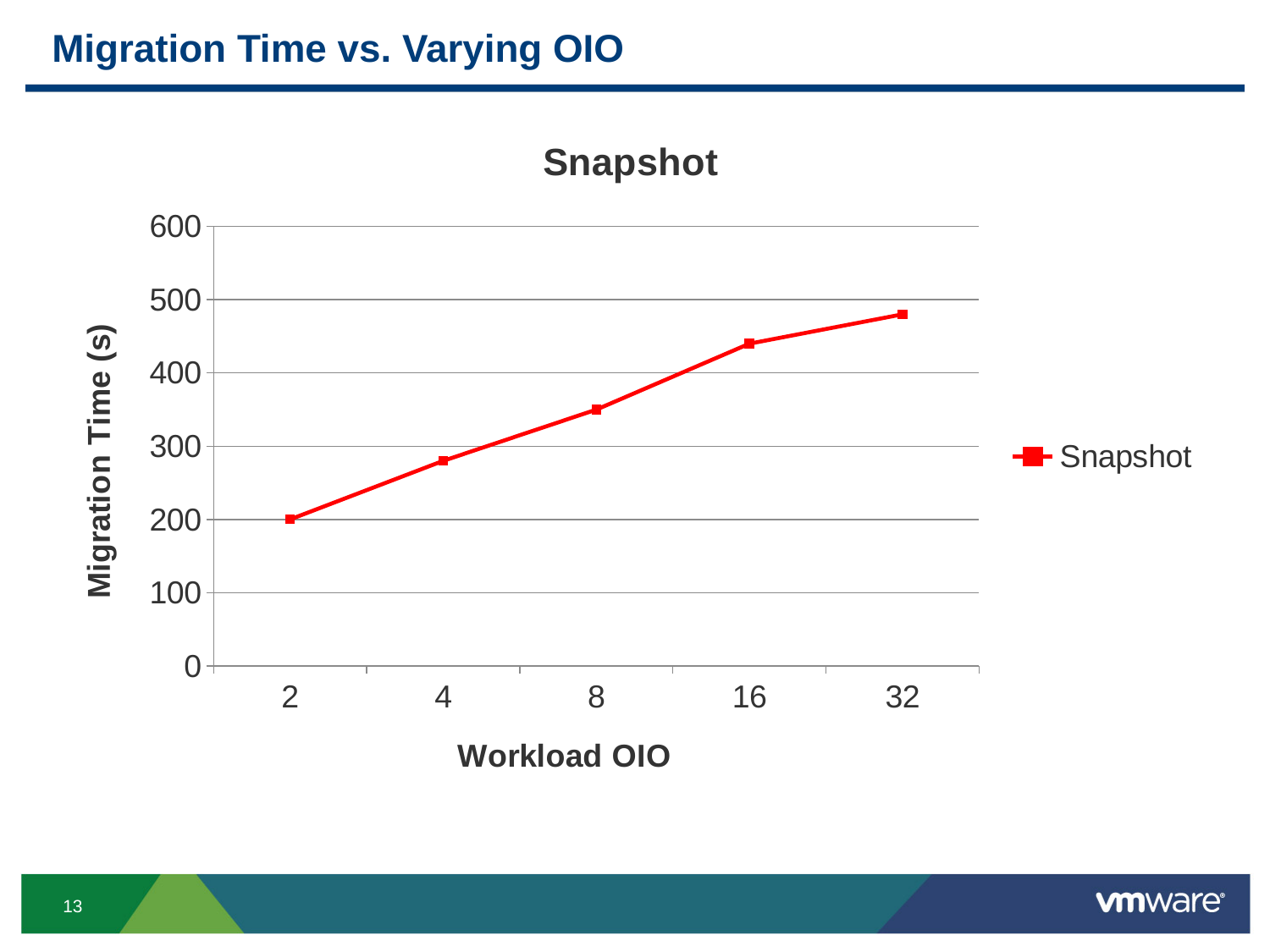
How many data points are plotted on the Snapshot line? 5 Is the migration time at a workload OIO of 4 greater or less than 300? less Is the migration time at a workload OIO of 16 greater or less than 400? greater Which has a larger migration time, a workload OIO of 8 or a workload OIO of 16? 16 What kind of chart is shown on the slide? line chart Does the migration time rise or fall as workload OIO increases along the x axis? rise Is the migration time at a workload OIO of 32 greater or less than 500? less How many series does the legend list? 1 Which workload OIO has the highest migration time? 32 Which workload OIO has the lowest migration time? 2 What is the migration time at a workload OIO of 2? 200 What is the title of the chart? Snapshot